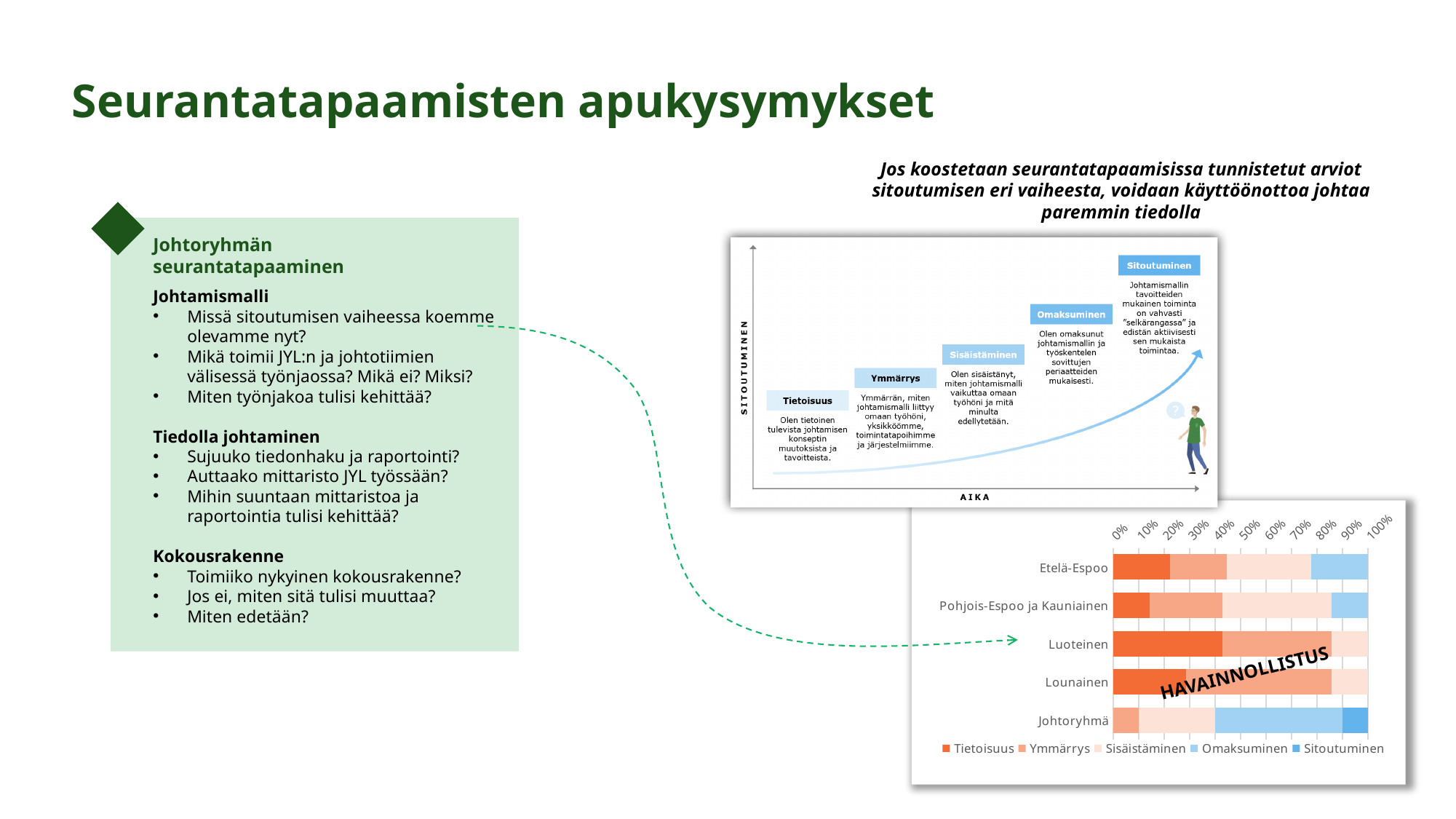
In the stacked bar chart, is the Omaksuminen share for Johtoryhmä greater or less than 30%? greater How many series does the legend of the stacked bar chart list? 5 In the stacked bar chart, which has the larger Tietoisuus share, Luoteinen or Johtoryhmä? Luoteinen In the stacked bar chart, is the Tietoisuus share for Luoteinen greater or less than 30%? greater In the stacked bar chart, is the Tietoisuus share for Etelä-Espoo greater or less than 10%? greater In the stacked bar chart, which has the larger Omaksuminen share, Johtoryhmä or Etelä-Espoo? Johtoryhmä In the stacked bar chart, which category is the only one with a Sitoutuminen segment? Johtoryhmä How many categories are shown on the vertical axis of the stacked bar chart? 5 In the stacked bar chart, which series is listed last in the legend? Sitoutuminen In the stacked bar chart, which series is listed first in the legend? Tietoisuus What kind of chart is the chart at the bottom right of the slide? Stacked bar chart